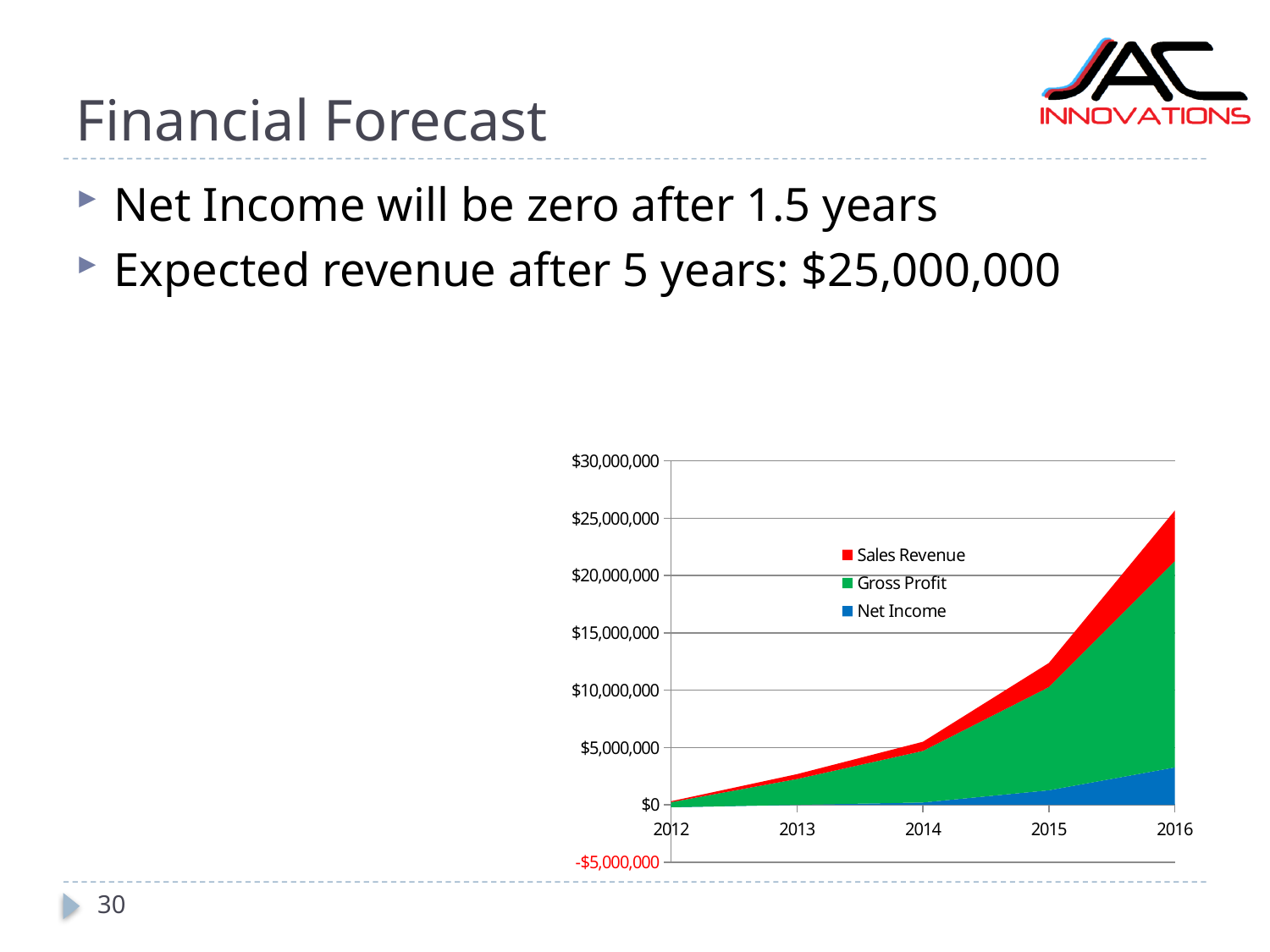
Is the Sales Revenue value for 2013 greater or less than $5,000,000? less Is the Net Income value for 2016 greater or less than $5,000,000? less Does Sales Revenue rise or fall from 2012 to 2016? Rise In which year is Sales Revenue lowest? 2012 How many series does the chart's legend list? 3 Which colour represents Net Income in the chart's legend? Blue In which year is Sales Revenue highest? 2016 In 2016, which is larger: Sales Revenue or Net Income? Sales Revenue What kind of chart is shown on the slide? Area chart How many years are shown along the x axis of the chart? 5